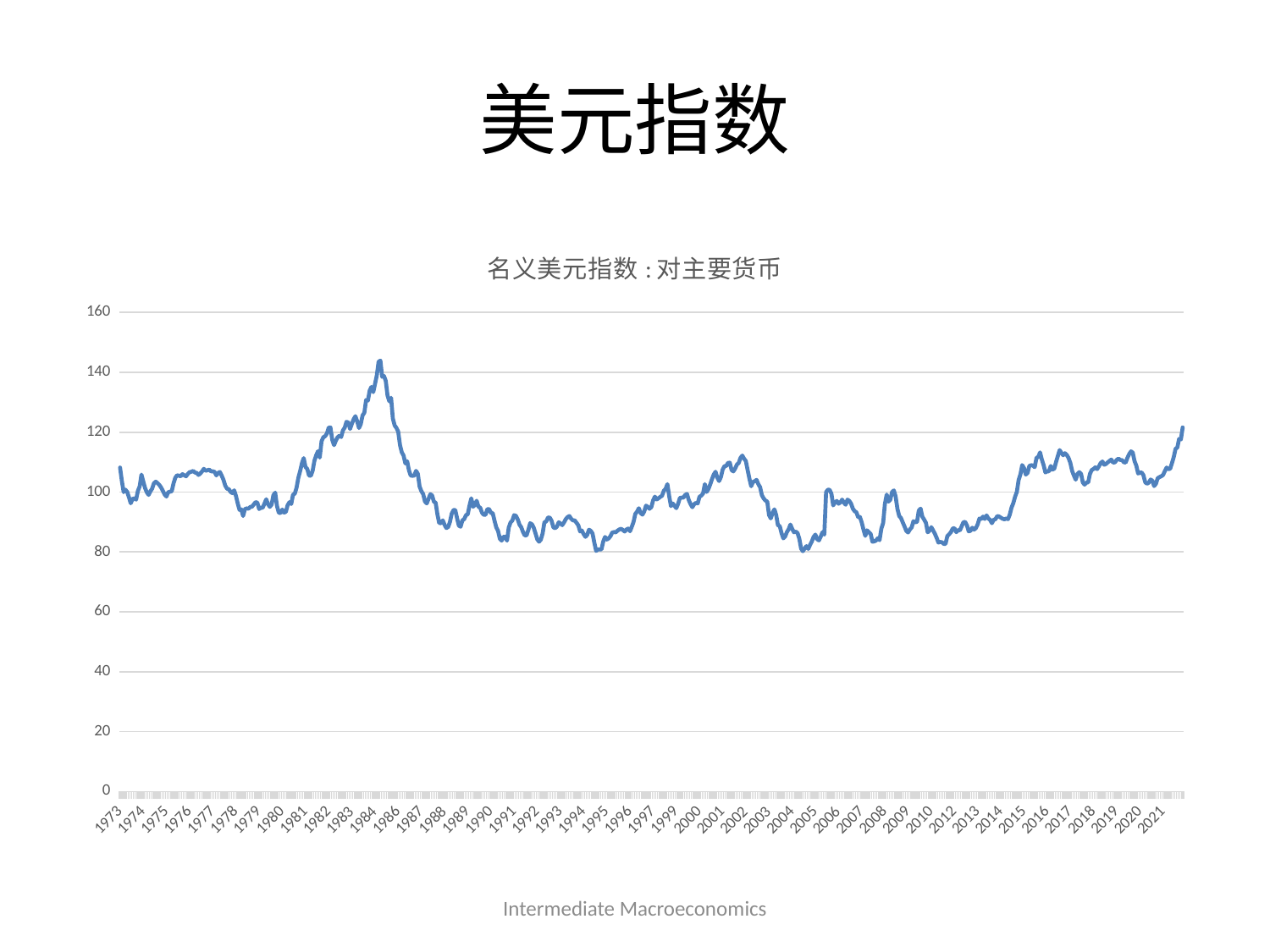
In which year does the nominal dollar index reach its highest value? 1985 Does the index rise or fall between 1980 and 1985? rise Which is larger, the index value in 1985 or the index value in 2005? 1985 Is the value of the index at the start of 1973 greater or less than 100? greater Is the value of the index in 1995 greater or less than 100? less What kind of chart is shown on the slide? line chart Is the value of the index in 1990 greater or less than 100? less Does the index rise or fall between 1985 and 1988? fall How many data series are plotted in the chart? 1 What is the title of the chart? 名义美元指数：对主要货币